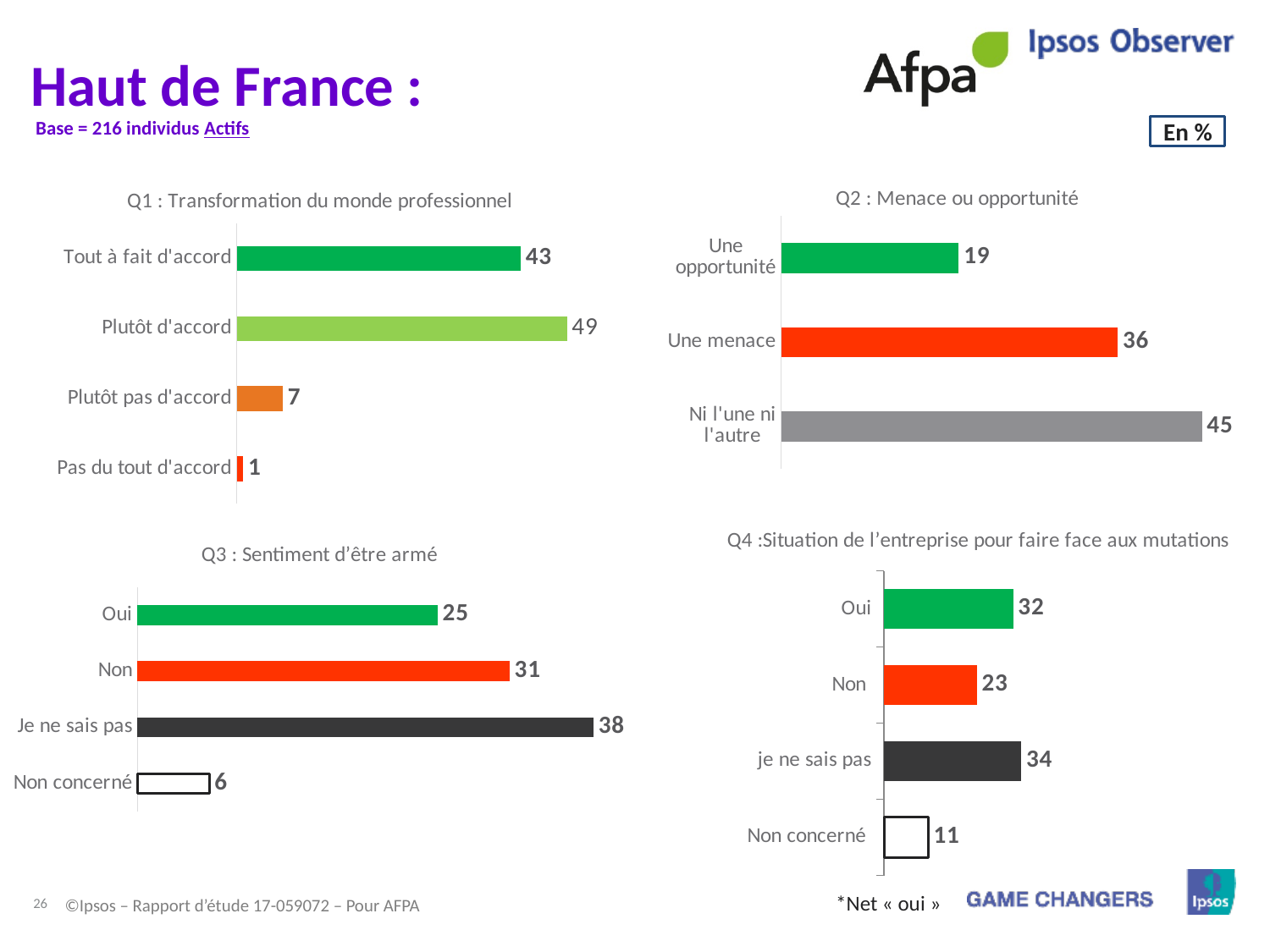
In the chart 'Q1 : Transformation du monde professionnel', which category has the lowest value? Pas du tout d'accord What kind of chart is 'Q4 : Situation de l'entreprise pour faire face aux mutations'? Bar chart In the chart 'Q2 : Menace ou opportunité', what is the value for 'Une menace'? 36 In the chart 'Q2 : Menace ou opportunité', how many categories are shown? 3 In the chart 'Q1 : Transformation du monde professionnel', what is the value for 'Plutôt d'accord'? 49 In the chart 'Q3 : Sentiment d'être armé', what is the difference between 'Non' and 'Oui'? 6 In the chart 'Q3 : Sentiment d'être armé', what is the value for 'Je ne sais pas'? 38 In the chart 'Q3 : Sentiment d'être armé', which is larger, 'Oui' or 'Non'? Non In the chart 'Q1 : Transformation du monde professionnel', what is the difference between 'Tout à fait d'accord' and 'Plutôt pas d'accord'? 36 In the chart 'Q2 : Menace ou opportunité', which category has the highest value? Ni l'une ni l'autre In the chart 'Q4 : Situation de l'entreprise pour faire face aux mutations', what is the value for 'Non concerné'? 11 In the chart 'Q4 : Situation de l'entreprise pour faire face aux mutations', which category has the highest value? je ne sais pas